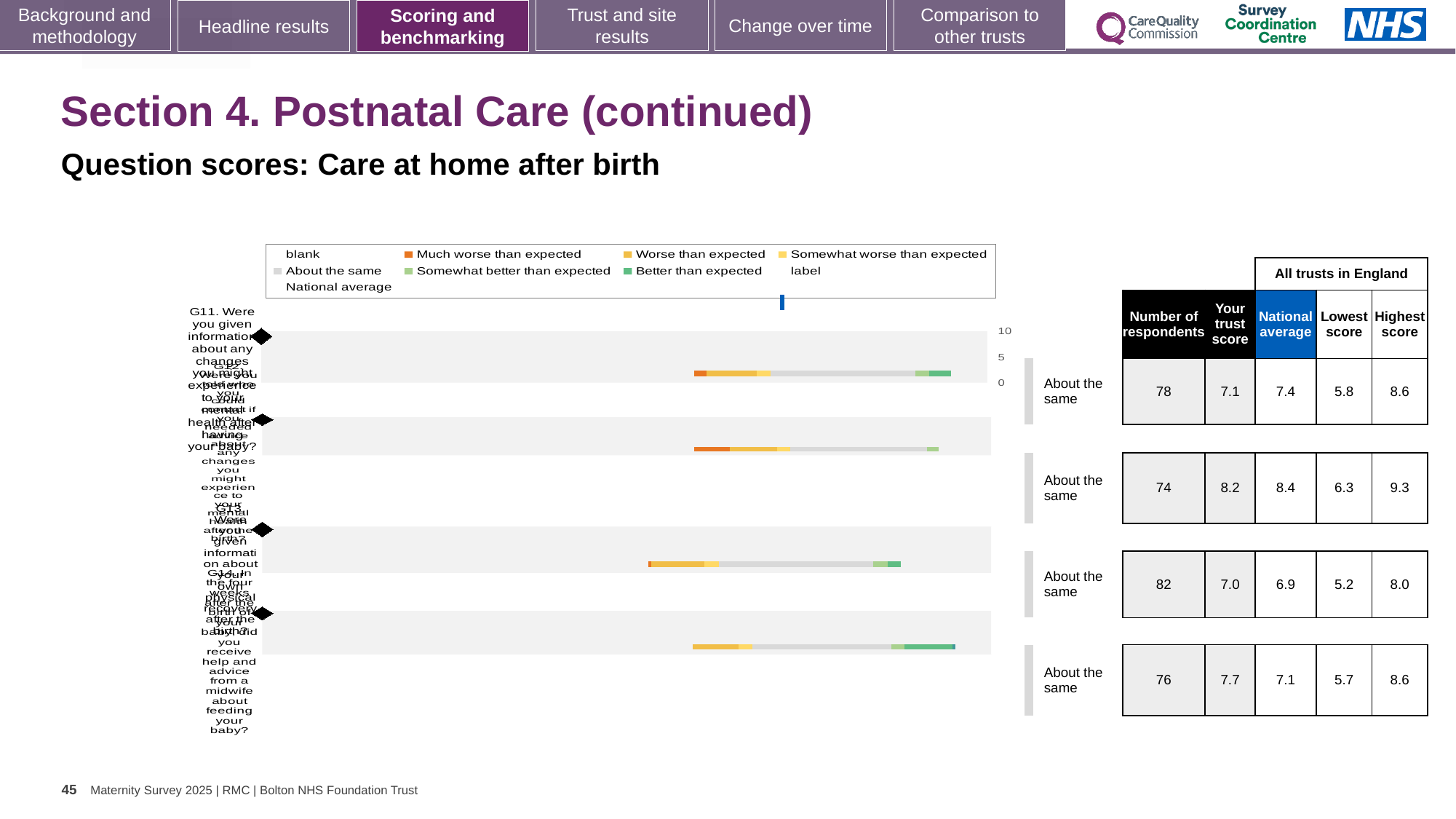
What is the subtitle describing the question scores shown on the slide? Question scores: Care at home after birth What comparison label is shown next to each of the four bars in the chart? About the same In the table beside the chart, which row has the highest 'Your trust score', and what is it? second row, 8.2 In the table beside the chart, what is the 'Lowest score' in the third row? 5.2 How many question bars are plotted in the chart? 4 In the table beside the chart, what is the 'Highest score' in the second row? 9.3 In the table beside the chart, is your trust score in the bottom row higher or lower than the national average? higher What kind of chart is shown on the slide? bar chart In the table beside the chart, what is the number of respondents in the top row? 78 In the chart legend, what colour is used for 'Much worse than expected'? orange In the table beside the chart, what is the lowest 'National average' value shown? 6.9 In the table beside the chart, what is the difference between the national average and your trust score in the top row? 0.3